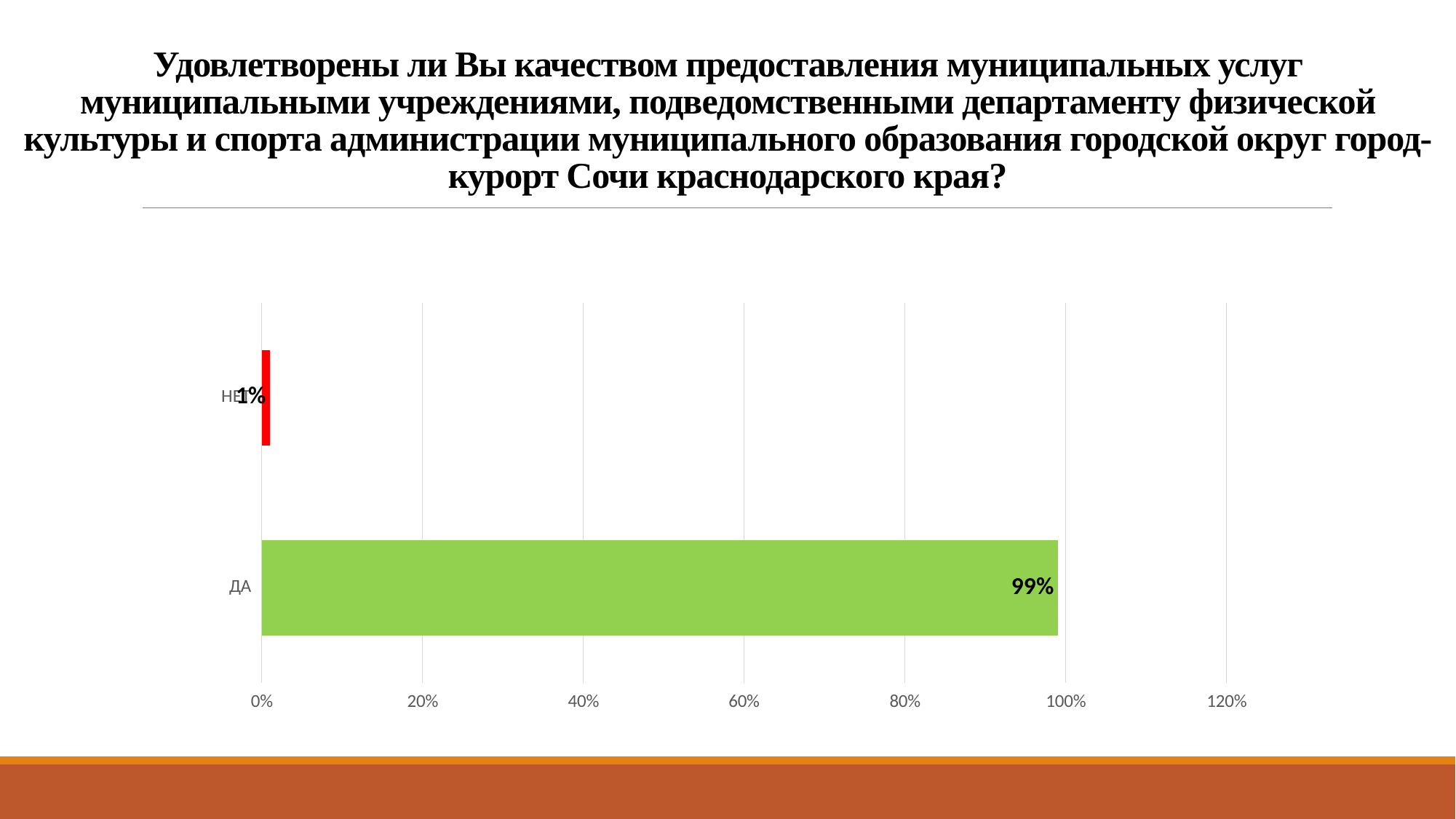
What is the value for НЕТ? 1% What is the value for ДА? 99% What colour is the bar for ДА? green What kind of chart is shown on the slide? bar chart What is the difference between the values for ДА and НЕТ? 98% What is the highest tick value shown on the horizontal axis? 120% Which category has the highest value? ДА Which is larger, the value for ДА or the value for НЕТ? ДА Is the value for НЕТ greater or less than 20%? less Is the value for ДА greater or less than 80%? greater How many categories are shown in the chart? 2 Which category has the lowest value? НЕТ